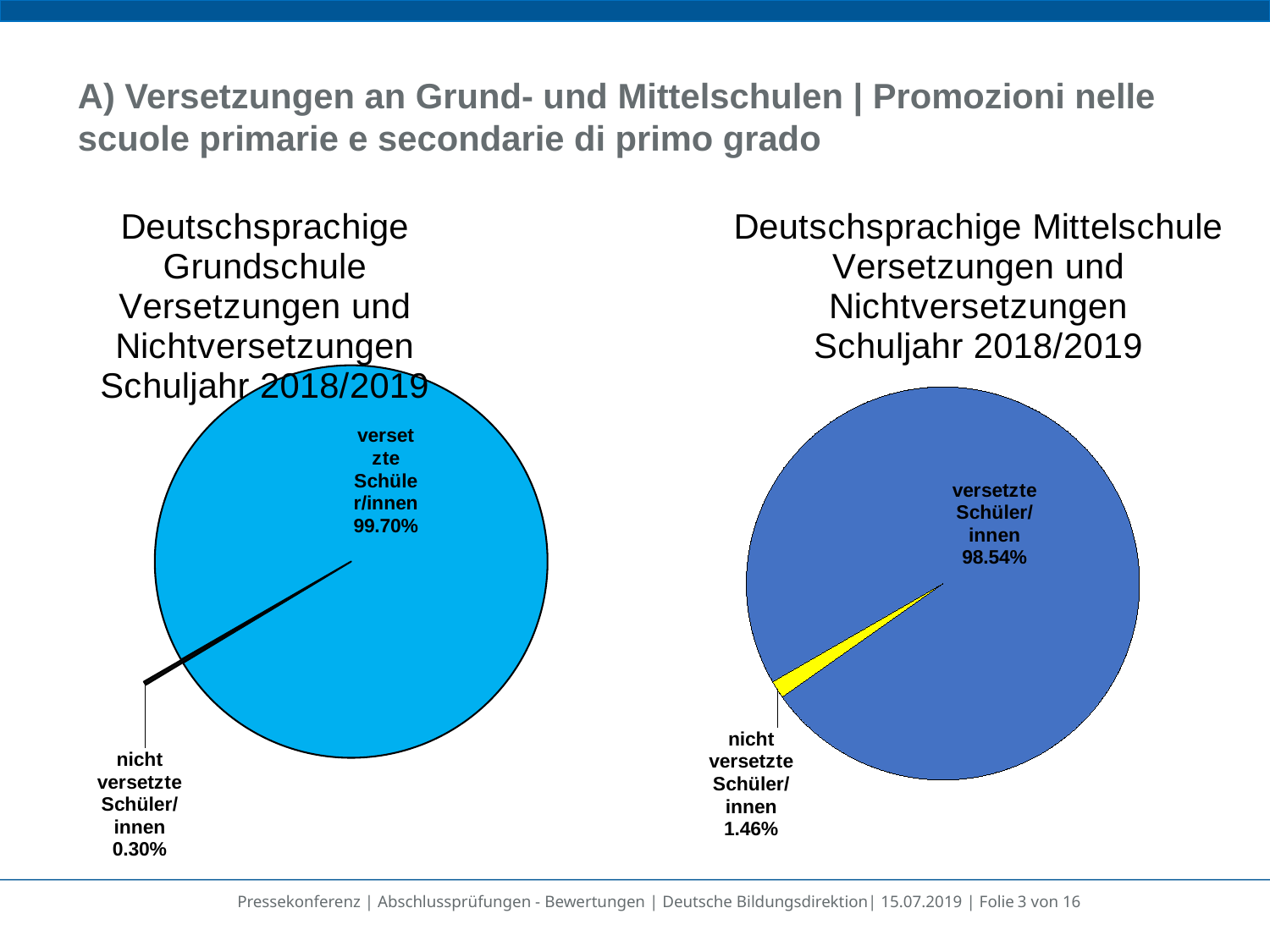
In the left pie chart (Deutschsprachige Grundschule), what percentage of pupils were not promoted (nicht versetzte Schüler/innen)? 0.30% Which school year do both pie charts refer to? Schuljahr 2018/2019 In the right pie chart (Deutschsprachige Mittelschule), which category has the smallest share? nicht versetzte Schüler/innen What type of chart is used on the left side of the slide? Pie chart Which chart shows a higher share of non-promoted pupils, the left (Grundschule) or the right (Mittelschule)? Right (Mittelschule) In the right pie chart (Deutschsprachige Mittelschule), what percentage of pupils were not promoted (nicht versetzte Schüler/innen)? 1.46% In the left pie chart (Deutschsprachige Grundschule), which category has the largest share? versetzte Schüler/innen In the left pie chart (Deutschsprachige Grundschule), what percentage of pupils were promoted (versetzte Schüler/innen)? 99.70% In the right pie chart (Deutschsprachige Mittelschule), what percentage of pupils were promoted (versetzte Schüler/innen)? 98.54% What colour is the non-promoted slice in the right pie chart (Deutschsprachige Mittelschule)? Yellow What is the difference between the promoted share in the left pie chart (Grundschule) and the promoted share in the right pie chart (Mittelschule)? 1.16% How many slices does the right pie chart (Deutschsprachige Mittelschule) have? 2